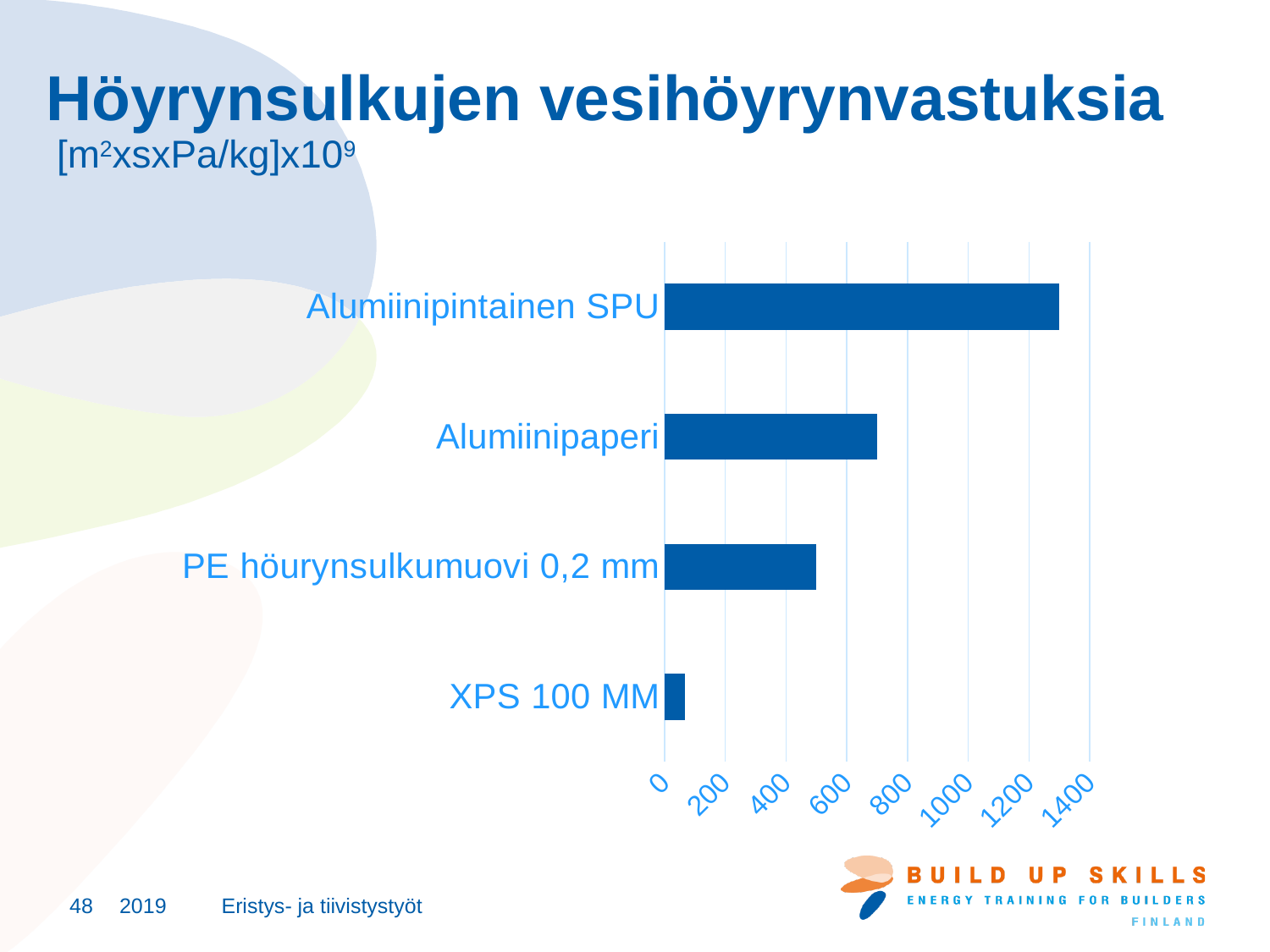
How many categories are plotted in the chart? 4 What is the highest tick value shown on the value axis of the chart? 1400 Is the value for XPS 100 MM greater or less than 200? less Which category has the lowest value in the chart? XPS 100 MM What is the title of the slide containing the chart? Höyrynsulkujen vesihöyrynvastuksia Is the value for Alumiinipintainen SPU greater or less than 1200? greater Is the value for Alumiinipaperi greater or less than 800? less Which has a larger value, Alumiinipaperi or PE höurynsulkumuovi 0,2 mm? Alumiinipaperi What kind of chart is shown on the slide? bar chart Which category has the highest value in the chart? Alumiinipintainen SPU